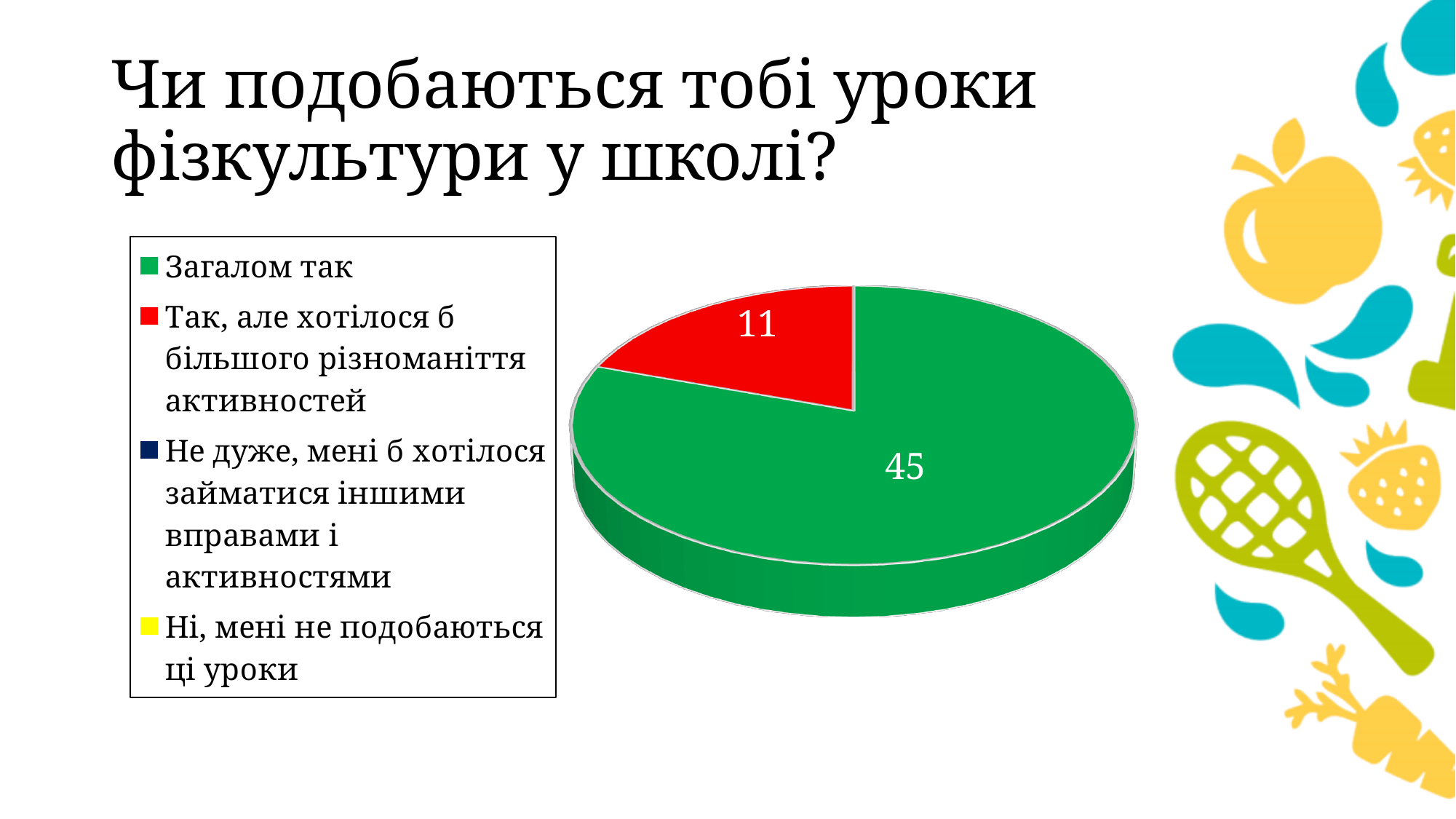
What value is shown for the "Загалом так" slice of the pie chart? 45 Which of the two labelled slices is smaller? Так, але хотілося б більшого різноманіття активностей How many entries does the chart legend list? 4 What is the title of the slide containing the chart? Чи подобаються тобі уроки фізкультури у школі? Which is larger: the value for "Загалом так" or the value for "Так, але хотілося б більшого різноманіття активностей"? Загалом так What value is shown for the "Так, але хотілося б більшого різноманіття активностей" slice of the pie chart? 11 How many slices with data labels are visible in the pie chart? 2 What colour is the "Загалом так" slice in the pie chart? Green What is the difference between the "Загалом так" value and the "Так, але хотілося б більшого різноманіття активностей" value? 34 Which category has the largest slice in the pie chart? Загалом так What type of chart is shown on the slide? Pie chart